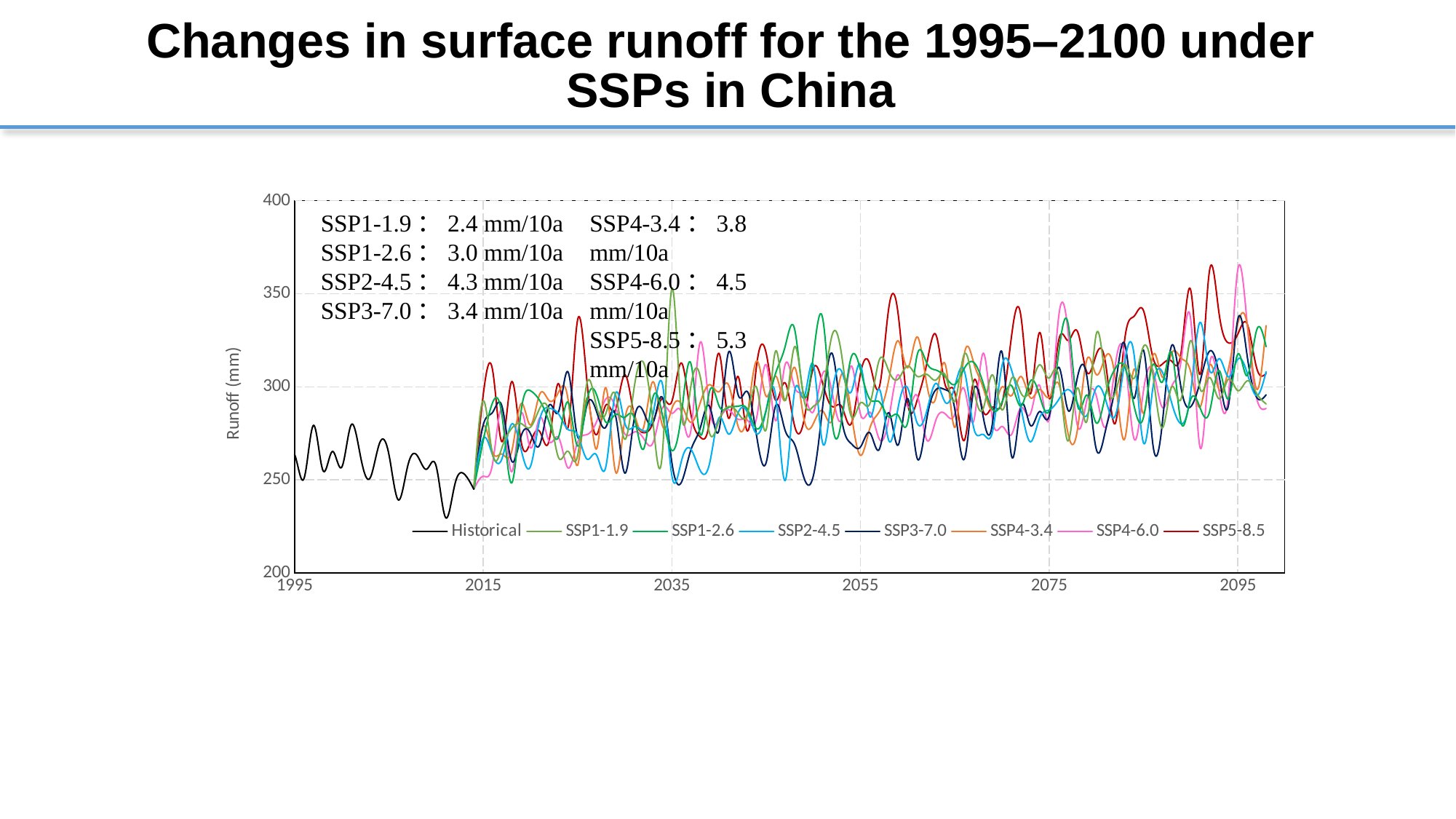
What is the difference between the printed trend rates of SSP5-8.5 and SSP1-1.9? 2.9 mm/10a Which has the larger printed trend rate, SSP2-4.5 or SSP1-2.6? SSP2-4.5 Which scenario has the lowest printed trend rate? SSP1-1.9 What trend rate is printed for SSP2-4.5? 4.3 mm/10a How many series does the chart legend list? 8 What is the label of the y axis? Runoff (mm) What trend rate is printed for SSP5-8.5? 5.3 mm/10a Do the SSP5-8.5 runoff values generally rise or fall from 2015 to 2100? rise What kind of chart is shown on the slide? line chart Which scenario has the highest printed trend rate? SSP5-8.5 Is the highest value of the Historical series greater or less than 300? less What trend rate is printed for SSP1-1.9? 2.4 mm/10a